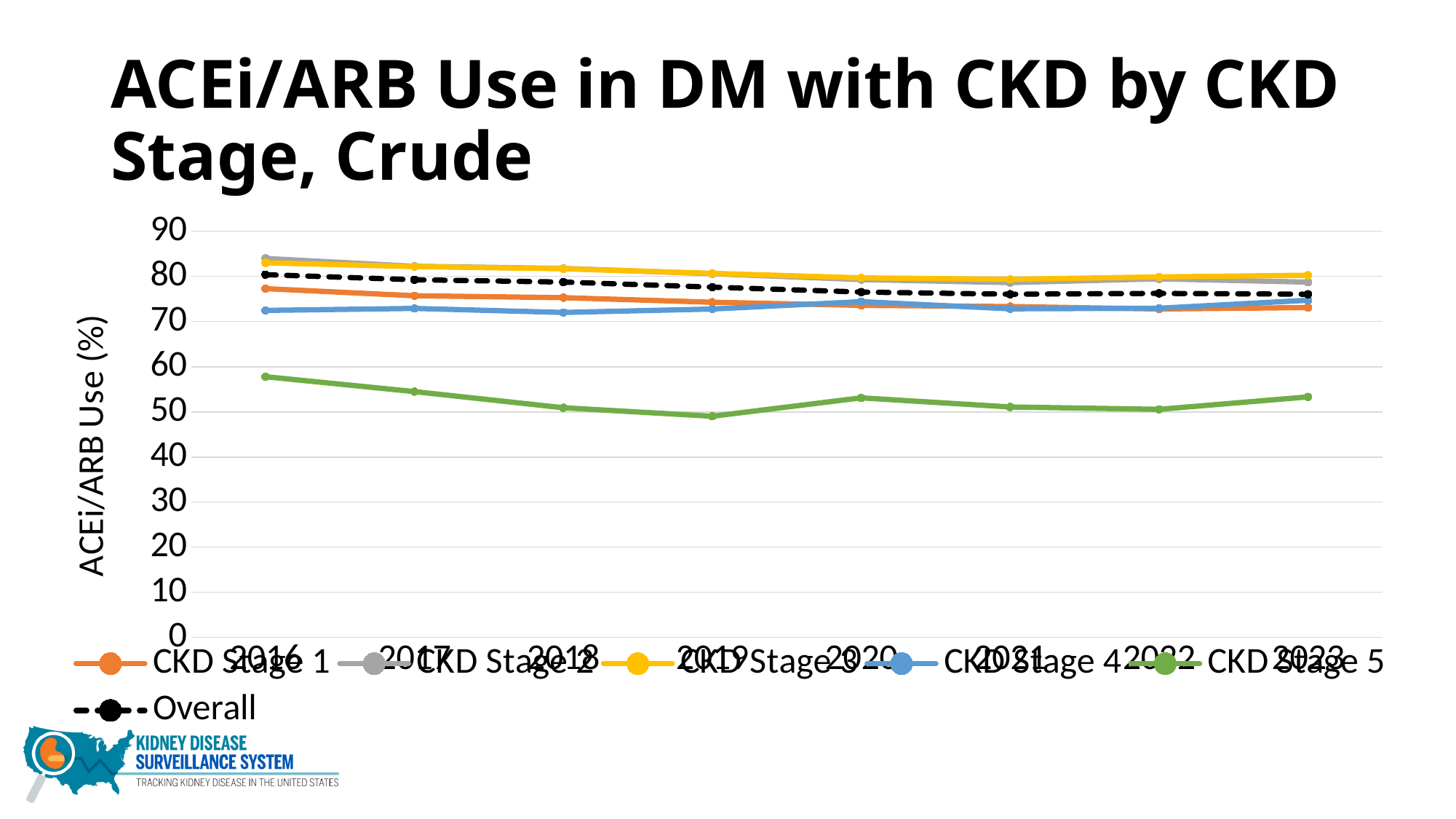
Is the value for Overall in 2023 greater or less than 80? less Is the value for CKD Stage 3 in 2016 greater or less than 80? greater How many series does the legend list? 6 What kind of chart is shown on the slide? line chart Is the value for CKD Stage 1 in 2016 greater or less than 80? less Which series is drawn with a dashed line? Overall Does the CKD Stage 1 line rise or fall from 2016 to 2023? fall Which series has the lowest ACEi/ARB use across all years? CKD Stage 5 How many years are plotted along the x axis? 8 In 2020, which is larger: CKD Stage 4 or CKD Stage 5? CKD Stage 4 What is the label on the y axis? ACEi/ARB Use (%)